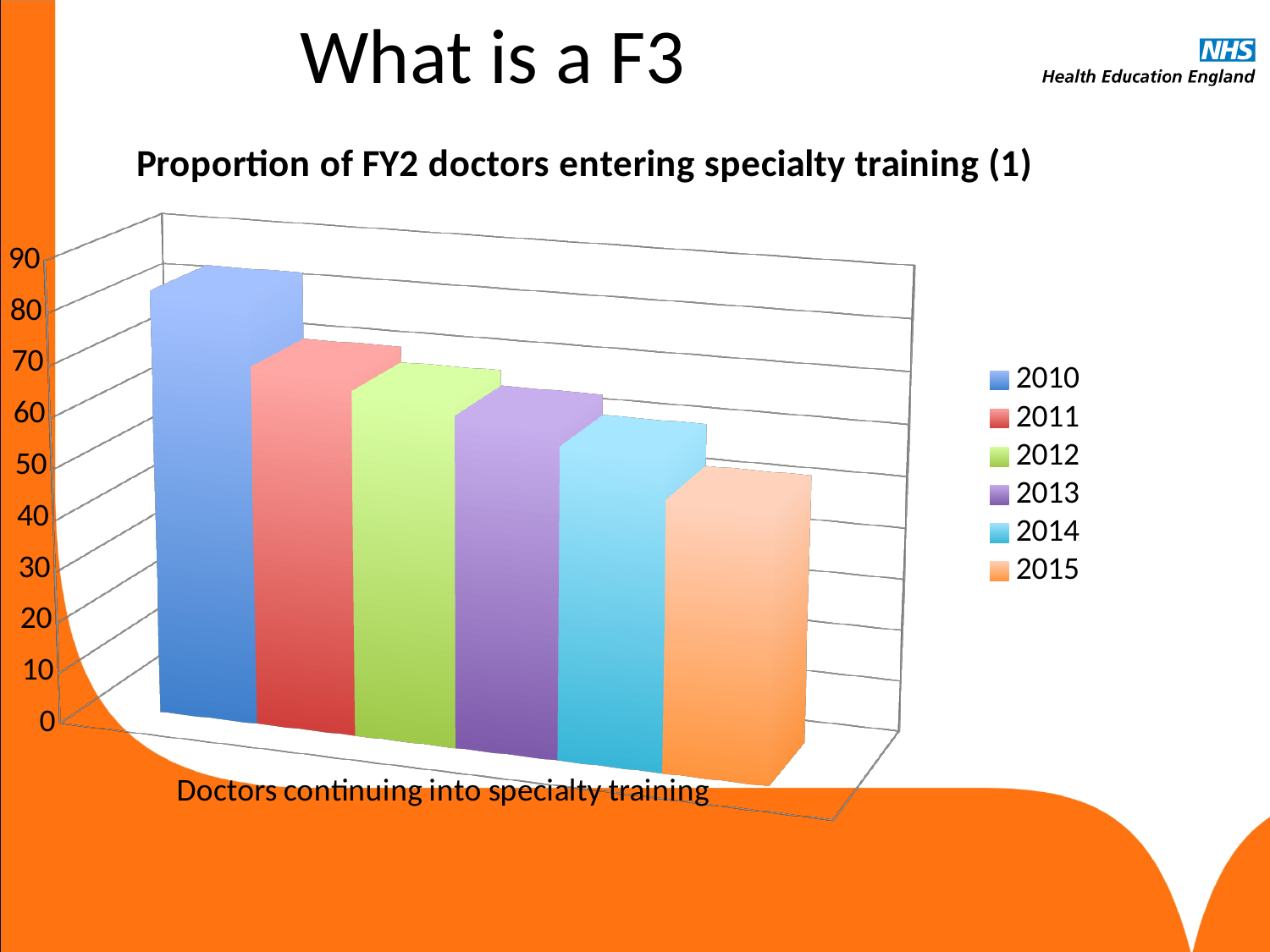
What is the title of the chart? Proportion of FY2 doctors entering specialty training (1) Is the value for 2010 greater or less than 70? greater Do the values rise or fall from 2010 to 2015? Fall Which is larger, the value for 2010 or the value for 2015? 2010 How many series does the legend list? 6 Which is larger, the value for 2011 or the value for 2014? 2011 Which year has the highest value for doctors continuing into specialty training? 2010 Is the value for 2015 greater or less than 60? less Is the value for 2014 greater or less than 70? less Which year has the lowest value for doctors continuing into specialty training? 2015 What is the category label shown on the x axis of the chart? Doctors continuing into specialty training What kind of chart is shown on the slide? Bar chart